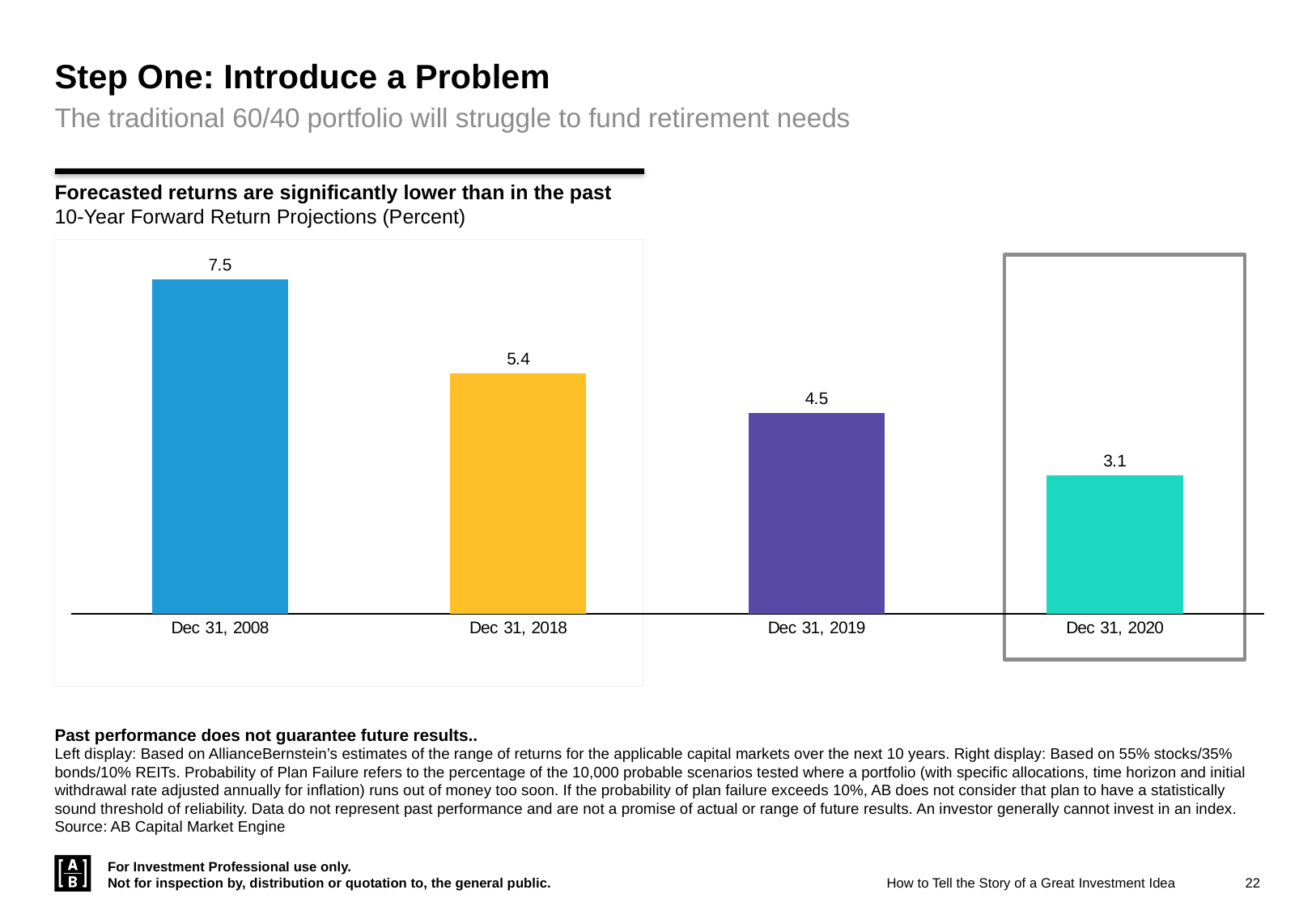
Do the projected returns rise or fall from Dec 31, 2008 to Dec 31, 2020? Fall What is the 10-year forward return projection for Dec 31, 2020? 3.1 What is the 10-year forward return projection for Dec 31, 2008? 7.5 What is the 10-year forward return projection for Dec 31, 2018? 5.4 What is the difference between the projections for Dec 31, 2008 and Dec 31, 2020? 4.4 What is the 10-year forward return projection for Dec 31, 2019? 4.5 What kind of chart is shown on the slide? Bar chart Which date has the highest 10-year forward return projection? Dec 31, 2008 How many dates are shown on the chart? 4 Which is larger, the projection for Dec 31, 2018 or for Dec 31, 2019? Dec 31, 2018 Which date has the lowest 10-year forward return projection? Dec 31, 2020 What is the difference between the projections for Dec 31, 2018 and Dec 31, 2019? 0.9